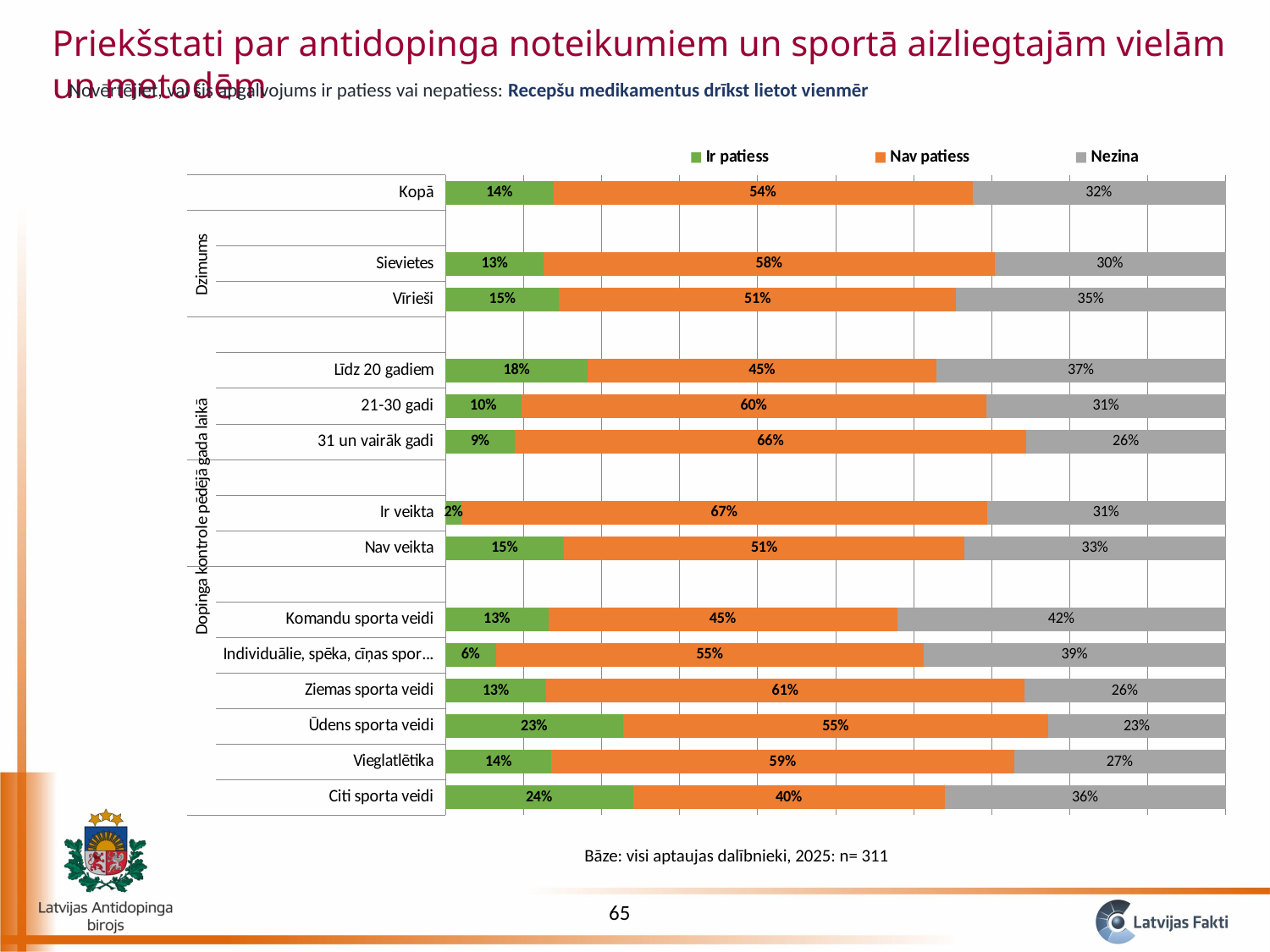
How many categories are plotted in the chart? 14 What is the "Nav patiess" value for Kopā? 54% What is the "Ir patiess" value for Ūdens sporta veidi? 23% Which category has the highest "Nav patiess" value? Ir veikta Which category has the highest "Ir patiess" value? Citi sporta veidi Which category has the lowest "Ir patiess" value? Ir veikta Which has a larger "Nezina" value, Līdz 20 gadiem or 31 un vairāk gadi? Līdz 20 gadiem What is the total of the stacked bar for Ziemas sporta veidi? 100% What is the "Nezina" value for Komandu sporta veidi? 42% How many series does the legend list? 3 What kind of chart is shown on the slide? Stacked bar chart What is the difference between the "Nav patiess" values for Sievietes and Vīrieši? 7%